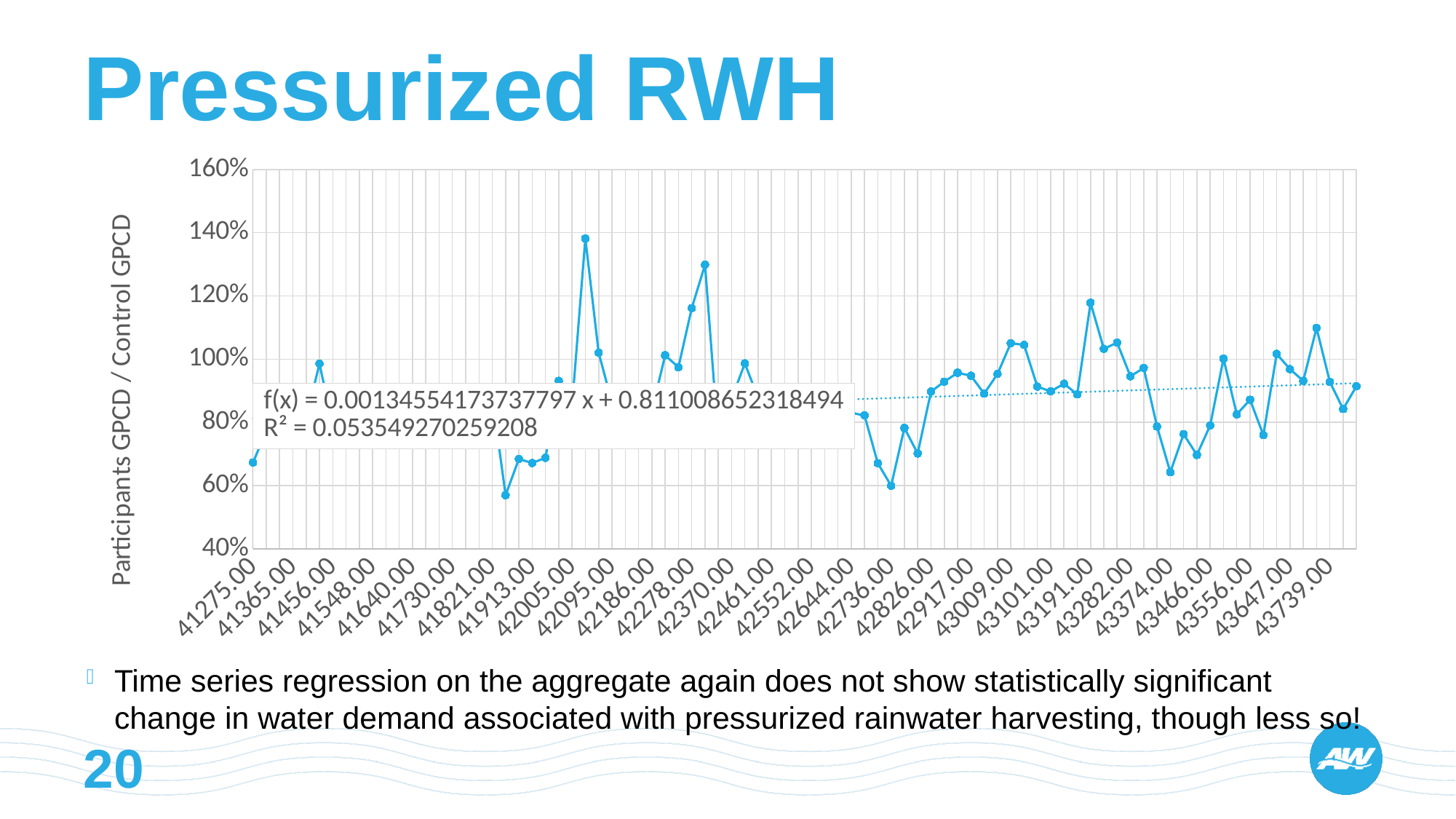
What trendline equation is displayed on the chart? f(x) = 0.00134554173737797 x + 0.811008652318494 Is the first plotted point (at 41275.00) greater or less than 80%? less What kind of chart is shown on the slide? line chart What is the first x-axis label on the chart? 41275.00 What is the highest value shown on the vertical axis? 160% What is the lowest value shown on the vertical axis? 40% Is the last plotted point on the right of the chart greater or less than 80%? greater Is the highest point on the line greater or less than 120%? greater What is the label on the vertical axis of the chart? Participants GPCD / Control GPCD Does the dotted trendline rise or fall from left to right? rises What R² value is shown on the chart? R² = 0.053549270259208